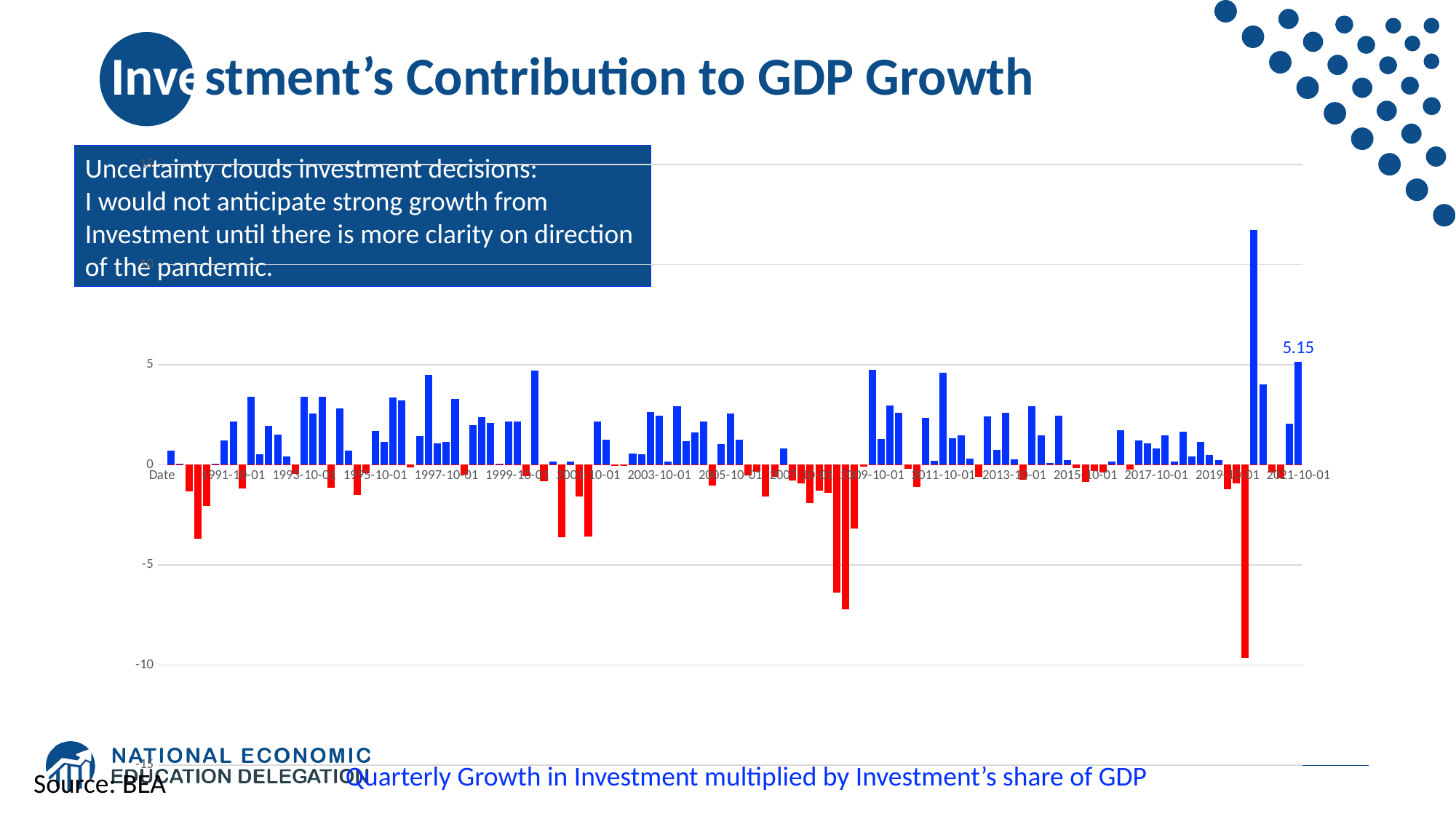
Is the lowest value plotted on the chart greater or less than -5? less What is the value of the data label shown on the bar for 2021-10-01? 5.15 Is the value for 2021-10-01 greater or less than 10? less What colour are the bars with negative values on the chart? red What is the title of the slide containing the chart? Investment's Contribution to GDP Growth Is the value for 2021-10-01 greater or less than 5? greater What kind of chart is shown on the slide? bar chart